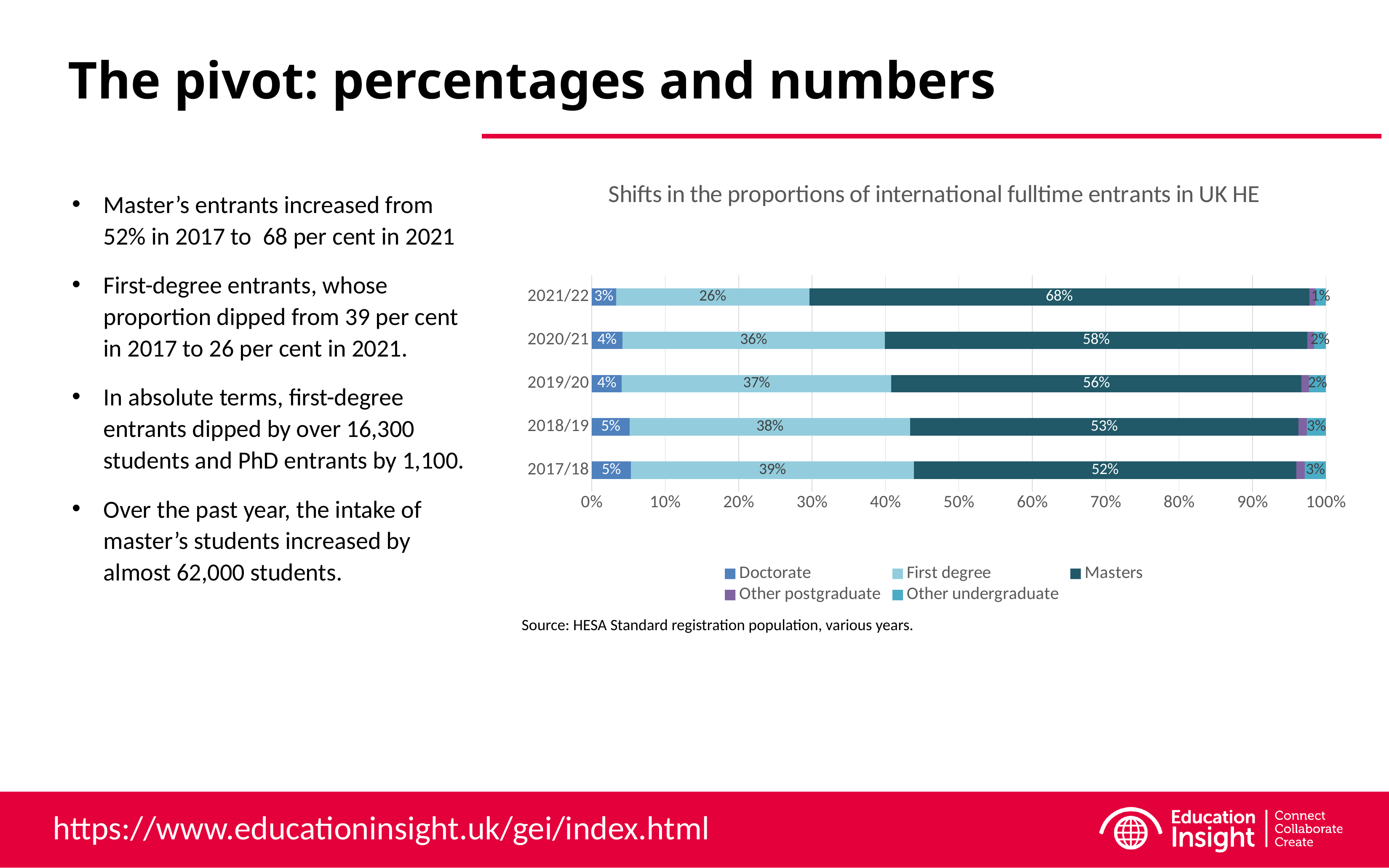
What is the First degree share for 2017/18? 39% Does the Masters share rise or fall from 2017/18 to 2021/22? Rise What is the Doctorate share for 2020/21? 4% In which year is the First degree share lowest? 2021/22 How many series does the legend list? 5 What is the Other undergraduate share for 2018/19? 3% What is the Masters share for 2021/22? 68% What kind of chart is shown on the slide? Stacked bar chart How many academic years are shown on the chart? 5 Which is larger in 2019/20: the First degree share or the Masters share? Masters What is the difference between the Masters share in 2021/22 and in 2017/18? 16 percentage points In which year is the Masters share highest? 2021/22